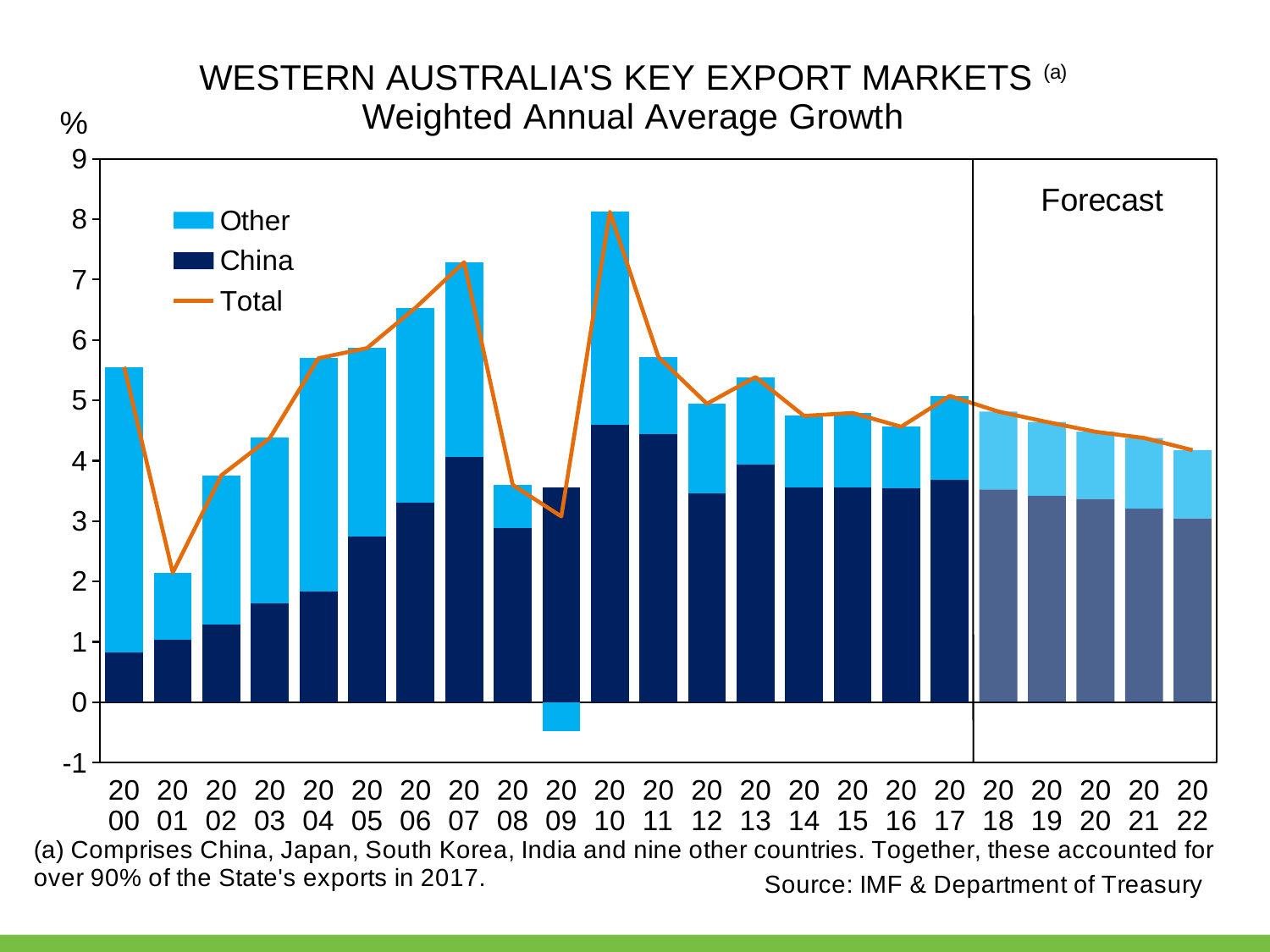
What kind of chart is shown on the slide? Stacked bar chart with a line How many series does the legend list? 3 In which year is the Total line at its highest? 2010 What label is shown over the shaded region on the right of the chart? Forecast Does the Total line rise or fall from 2018 to 2022? fall Which is larger, the China value for 2010 or the China value for 2000? 2010 In which year is the Total line at its lowest? 2001 Is the Total value for 2010 greater or less than 7? greater How many years are shown along the x axis? 23 Is the Other value for 2009 greater or less than 0? less Is the China value for 2000 greater or less than 1? less